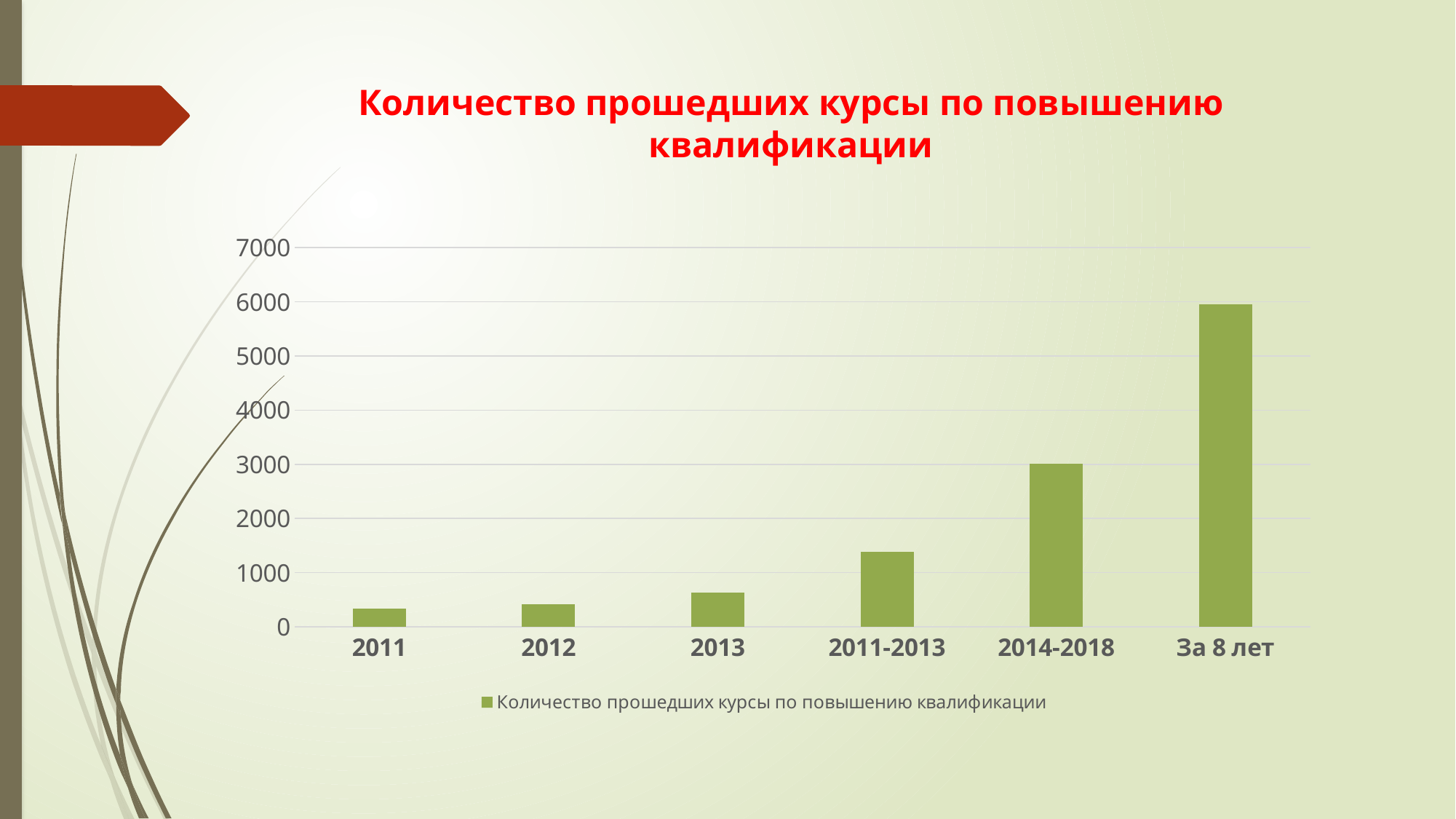
Is the value for За 8 лет greater or less than 5000? greater Is the value for 2013 greater or less than 1000? less Do the values rise or fall from left to right along the x axis? rise Is the value for 2011-2013 greater or less than 1000? greater Which category has the highest value? За 8 лет What kind of chart is shown on the slide? bar chart How many categories are shown on the x axis of the chart? 6 Which is larger, the value for 2013 or the value for 2012? 2013 How many series does the legend list? 1 Which category has the lowest value? 2011